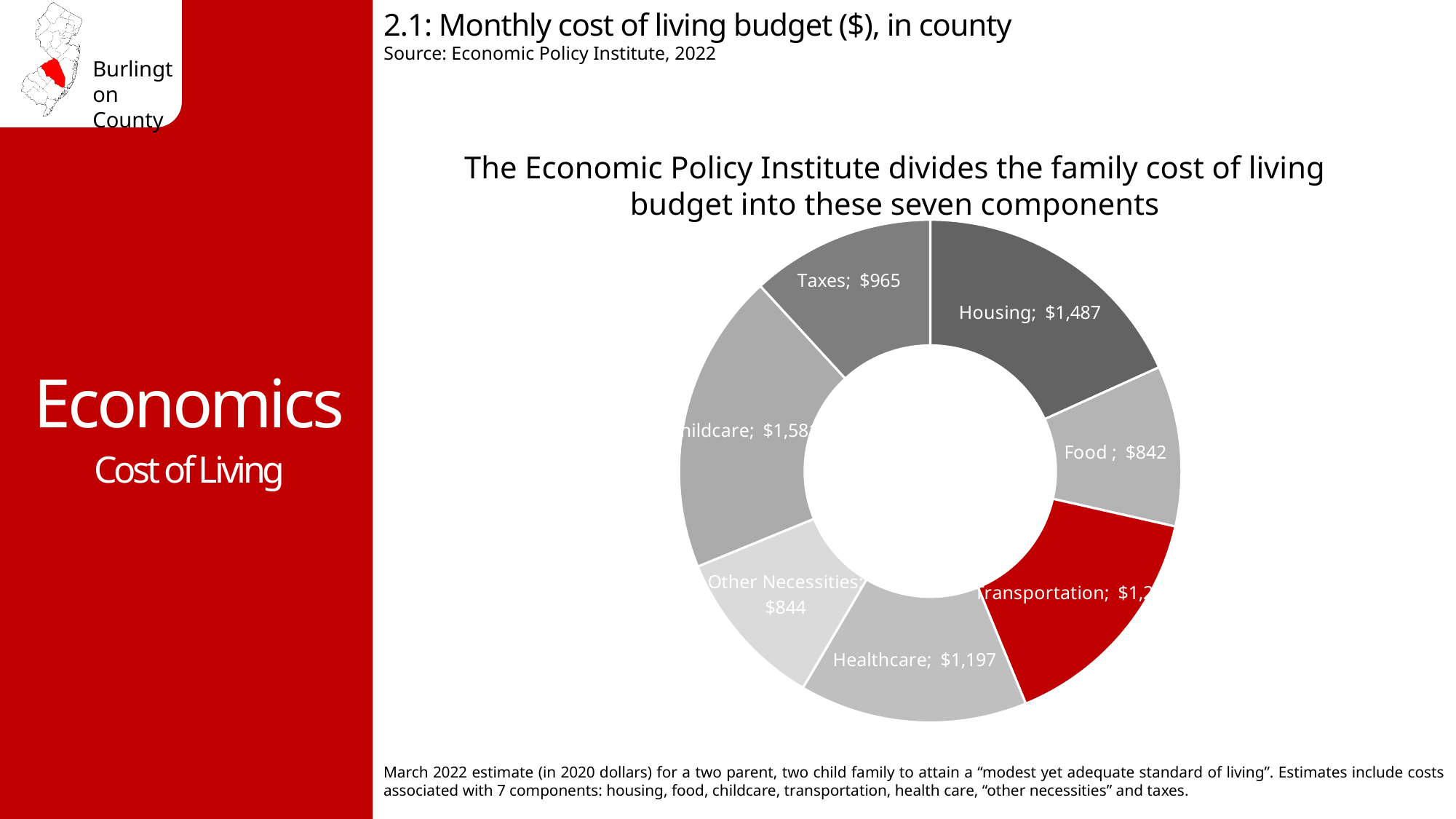
What is the difference between the Housing cost and the Taxes cost? $522 Which is larger, the cost for Housing or the cost for Taxes? Housing What is the monthly cost for Other Necessities? $844 What is the monthly cost for Housing? $1,487 What is the monthly cost for Taxes? $965 What is the monthly cost for Food? $842 Which is larger, the cost for Healthcare or the cost for Food? Healthcare What kind of chart is shown on the slide? Doughnut (pie) chart Which component's slice is coloured red? Transportation What is the monthly cost for Healthcare? $1,197 How many components are shown in the chart? 7 What is the difference between the Healthcare cost and the Food cost? $355